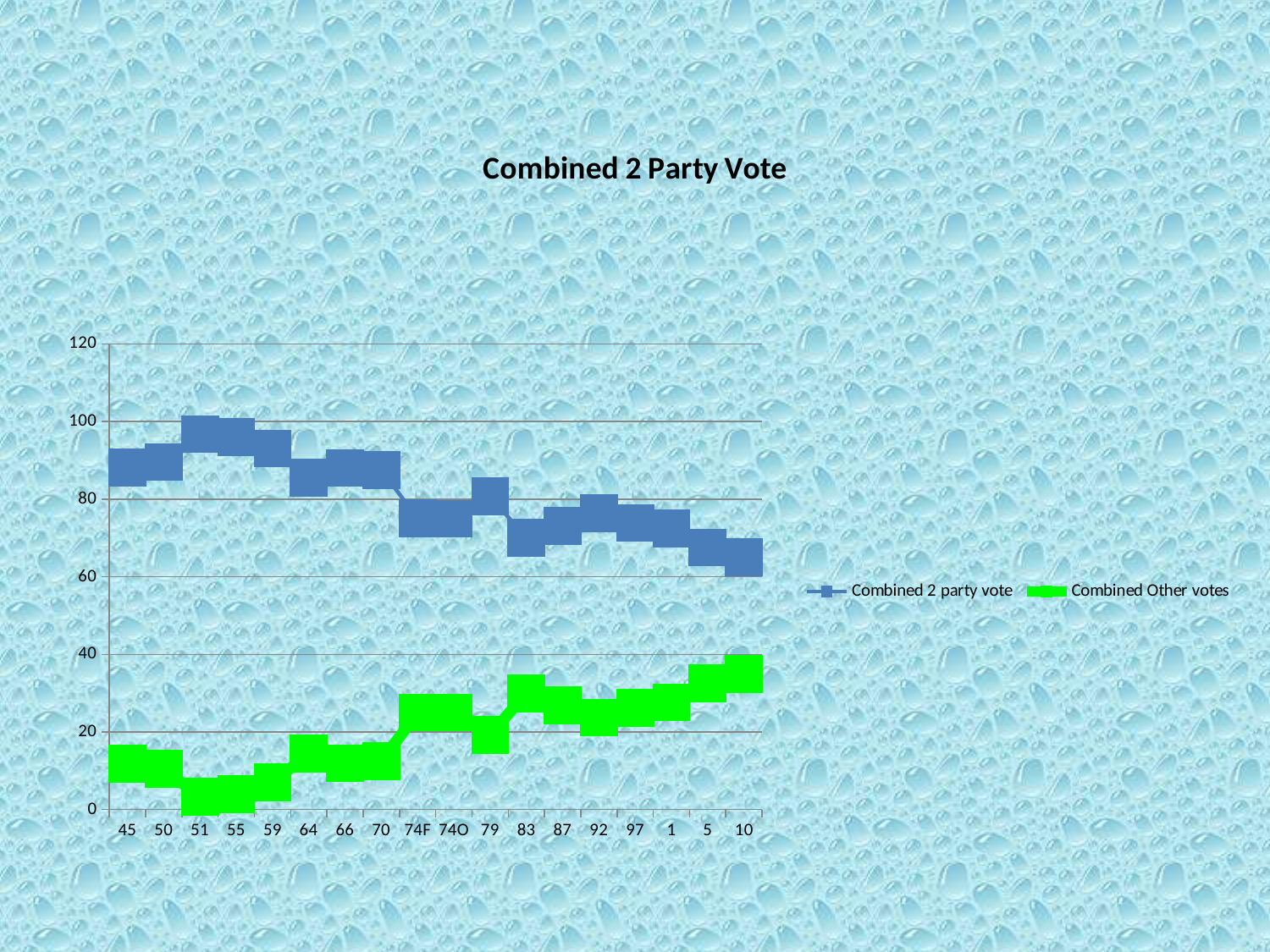
What kind of chart is shown on the slide? line chart Does the Combined 2 party vote series generally rise or fall from 45 to 10? fall What is the title of the chart? Combined 2 Party Vote How many series does the legend list? 2 Is the value for Combined 2 party vote at 10 greater or less than 80? less Which is larger at 45: Combined 2 party vote or Combined Other votes? Combined 2 party vote How many categories are shown on the x axis? 18 Does the Combined Other votes series generally rise or fall from 45 to 10? rise Is the value for Combined Other votes at 10 greater or less than 20? greater Which series is drawn in green? Combined Other votes Is the value for Combined Other votes at 51 greater or less than 20? less